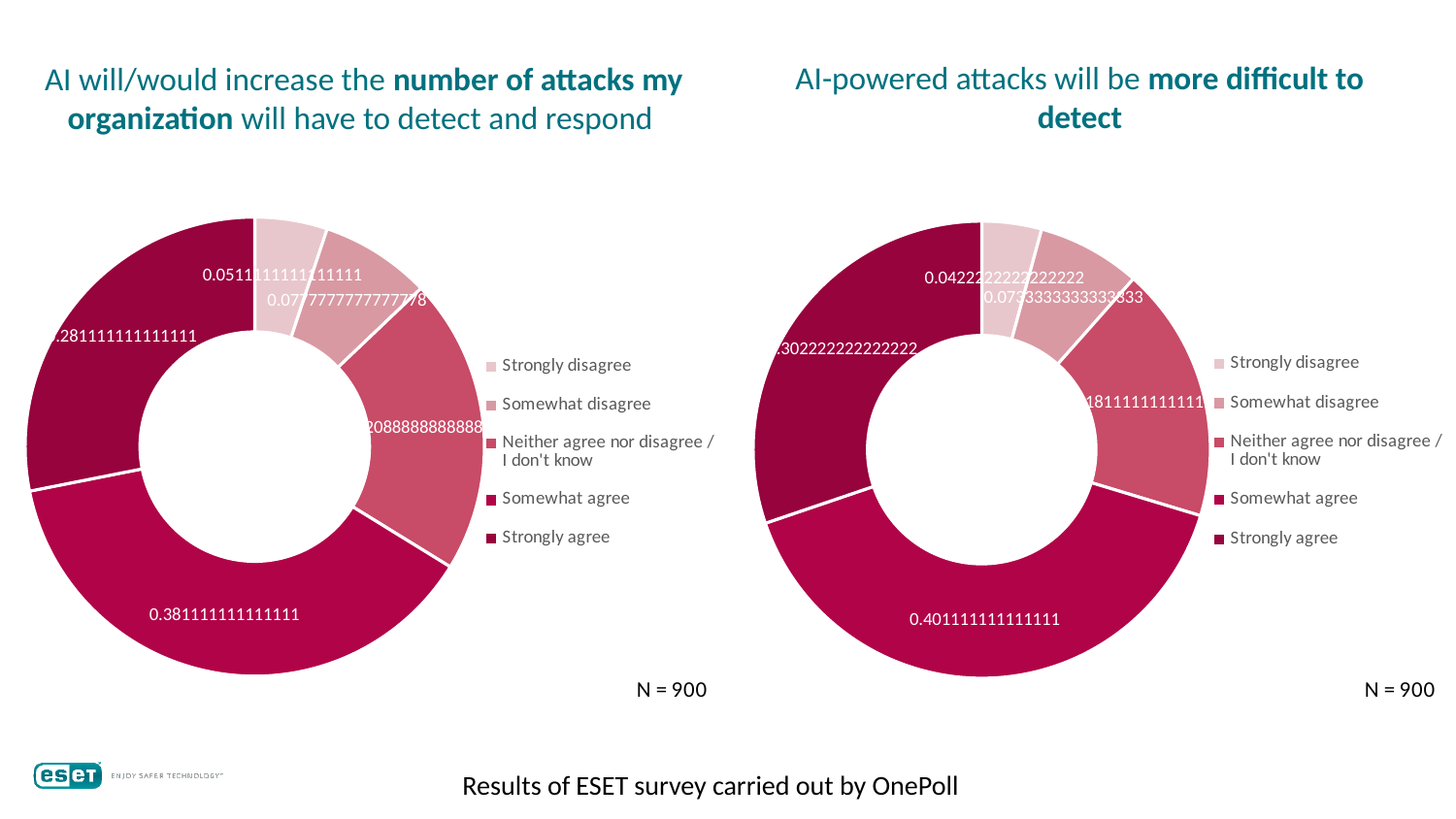
In the left chart, which is larger: Somewhat agree or Strongly agree? Somewhat agree In the left chart, what is the value for Strongly disagree? 0.0511111111111111 In the right chart, which category has the largest share? Somewhat agree Is the value for Somewhat agree larger in the left chart or the right chart? Right chart What type of chart is used on this slide? Doughnut (pie) chart In the right chart, what is the value for Strongly disagree? 0.0422222222222222 In the right chart, which category has the smallest share? Strongly disagree What sample size (N) is shown for the right chart? N = 900 In the chart titled 'AI will/would increase the number of attacks my organization will have to detect and respond', what is the value for Somewhat agree? 0.381111111111111 In the chart titled 'AI-powered attacks will be more difficult to detect', what is the value for Somewhat agree? 0.401111111111111 How many categories does the legend of the left chart list? 5 In the left chart, which category has the largest share? Somewhat agree